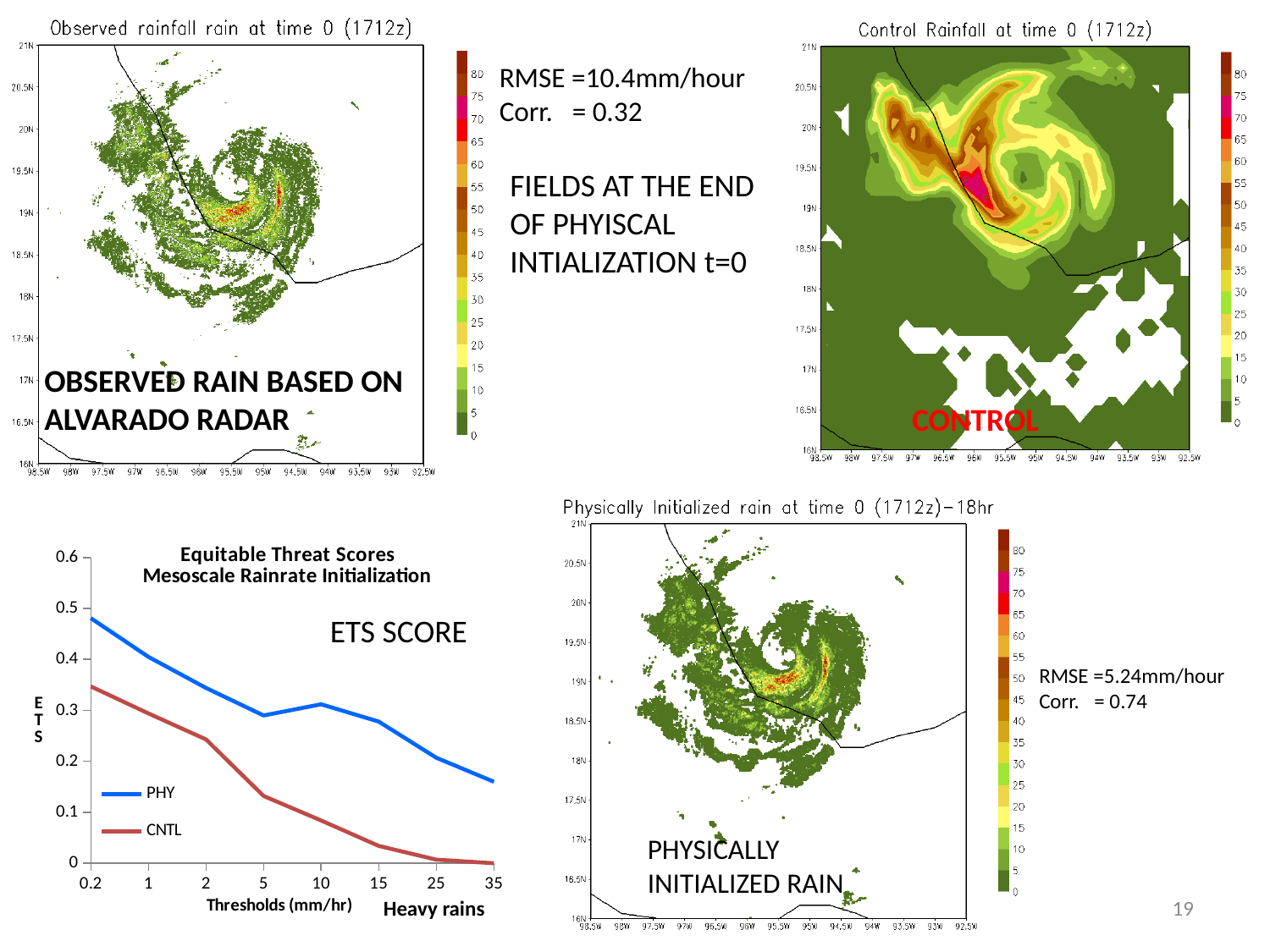
How many series does the legend of the Equitable Threat Scores chart list? 2 In the Equitable Threat Scores chart, is the CNTL value at threshold 0.2 greater or less than 0.3? greater What kind of chart is the Equitable Threat Scores chart? line chart In the Equitable Threat Scores chart, is the CNTL value at threshold 5 greater or less than 0.2? less What are the two series named in the legend of the Equitable Threat Scores chart? PHY and CNTL How many threshold values are marked along the x axis of the Equitable Threat Scores chart? 8 In the Equitable Threat Scores chart, is the PHY value at threshold 0.2 greater or less than 0.4? greater In the Equitable Threat Scores chart, does the CNTL series generally rise or fall as the threshold increases? fall What is the x-axis title of the Equitable Threat Scores chart? Thresholds (mm/hr) In the Equitable Threat Scores chart, at which threshold is the PHY series highest? 0.2 In the Equitable Threat Scores chart, which series has the larger ETS at threshold 10, PHY or CNTL? PHY